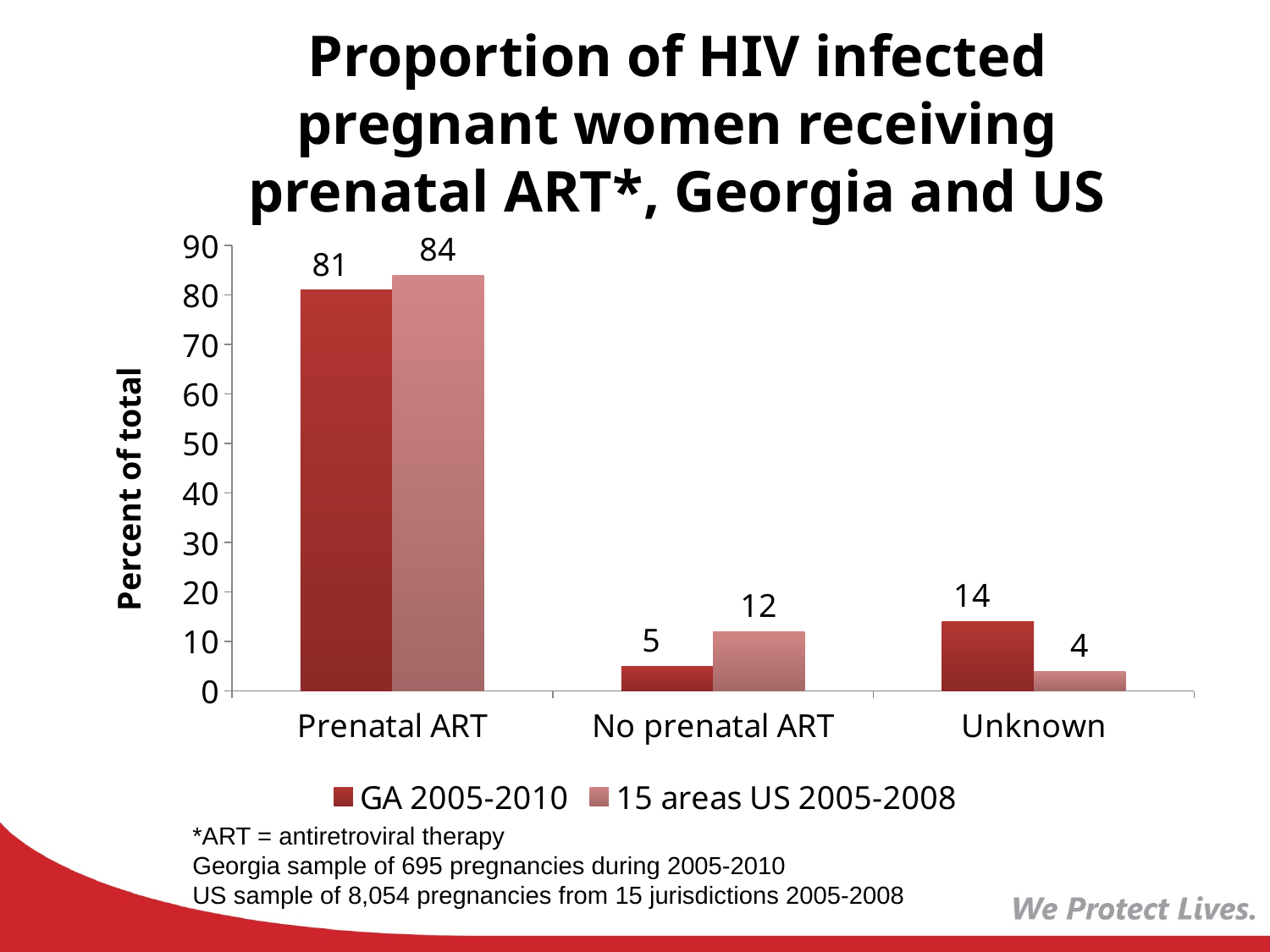
How many series does the legend list? 2 How many categories are shown on the x axis? 3 What is the value for Unknown in the GA 2005-2010 series? 14 What kind of chart is shown on the slide? Bar chart What is the difference between the GA 2005-2010 and 15 areas US 2005-2008 values for Unknown? 10 What is the value for Prenatal ART in the GA 2005-2010 series? 81 What is the label of the y axis? Percent of total What is the value for No prenatal ART in the 15 areas US 2005-2008 series? 12 What is the difference between the 15 areas US 2005-2008 and GA 2005-2010 values for Prenatal ART? 3 Which category has the highest value in the 15 areas US 2005-2008 series? Prenatal ART Which category has the lowest value in the GA 2005-2010 series? No prenatal ART For No prenatal ART, which series has the larger value, GA 2005-2010 or 15 areas US 2005-2008? 15 areas US 2005-2008